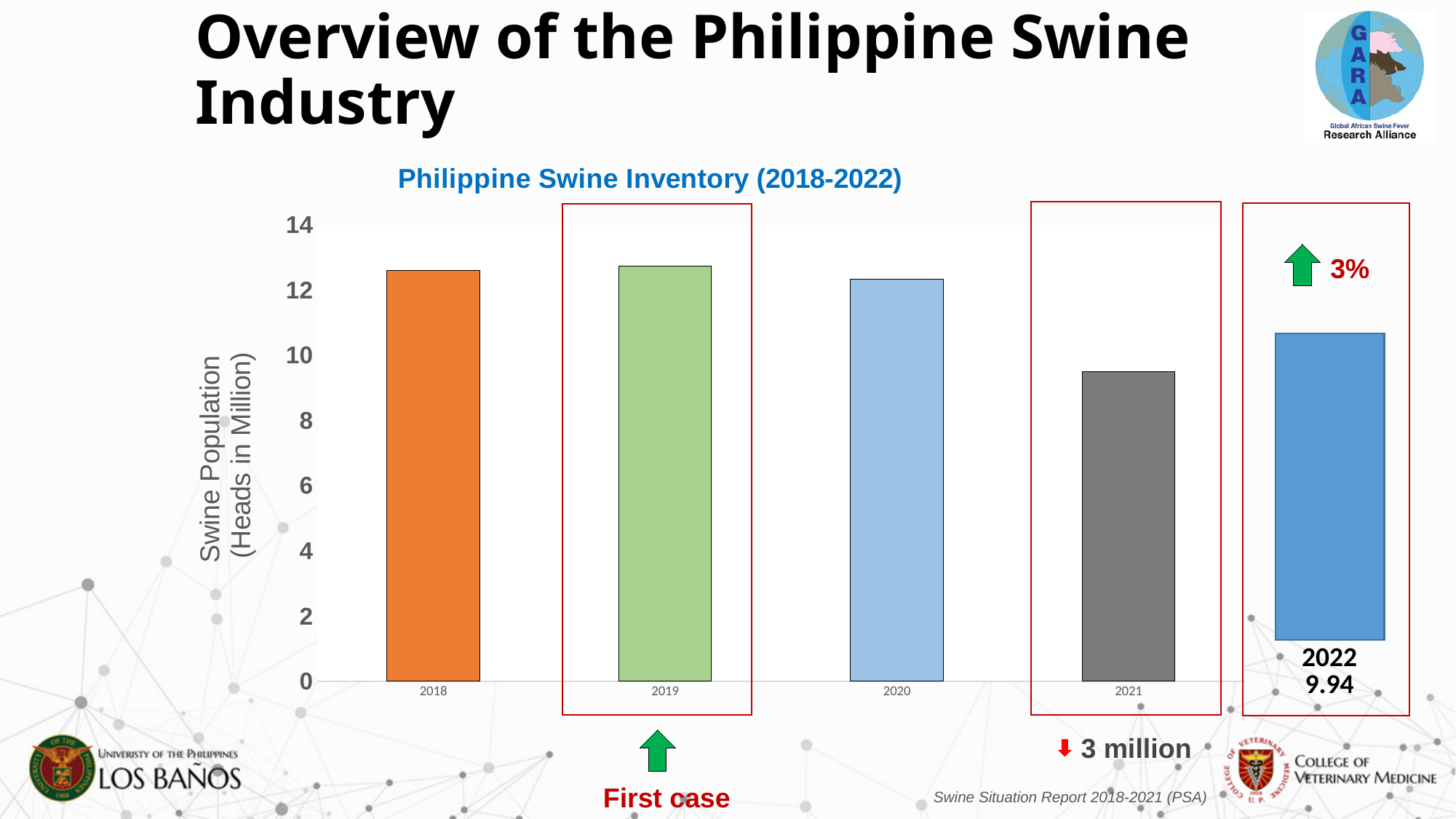
How many years are shown along the x axis of the chart? 5 Which is larger, the value for 2020 or the value for 2021? 2020 Which year has the lowest swine population on the chart? 2021 Is the value for 2020 greater or less than 12? greater Is the value for 2021 greater or less than 10? less From 2019 to 2021, do the values rise or fall? fall Which is larger, the value for 2018 or the value for 2021? 2018 What is the title of the chart? Philippine Swine Inventory (2018-2022) Is the value for 2018 greater or less than 12? greater What is the label on the y axis of the chart? Swine Population (Heads in Million) What kind of chart is shown on the slide? bar chart What value is printed for 2022 on the chart? 9.94